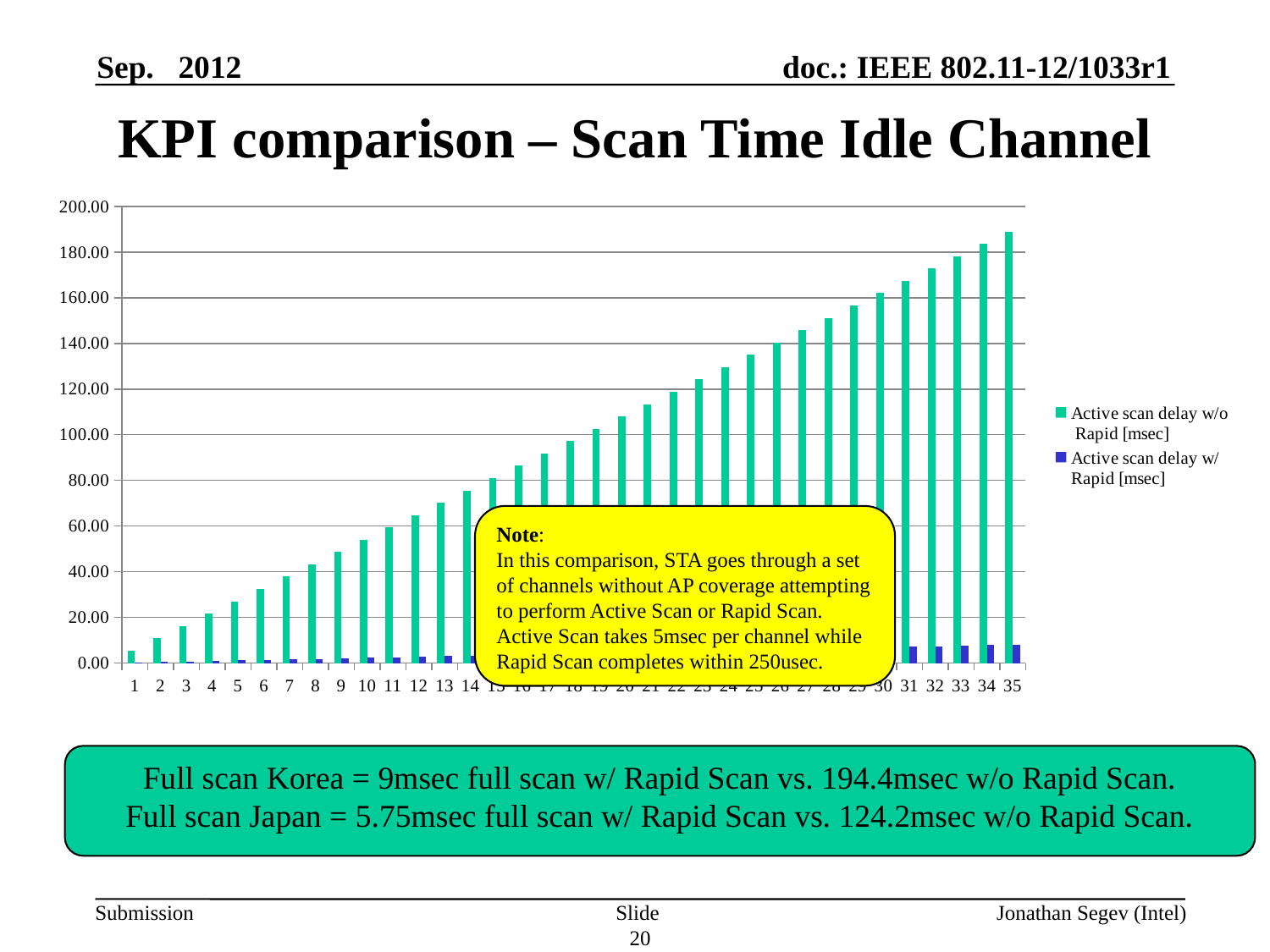
How many categories are shown along the x axis? 35 Do the values for 'Active scan delay w/o Rapid [msec]' rise or fall as the category number increases along the x axis? rise Which category has the lowest value for 'Active scan delay w/o Rapid [msec]'? 1 Which category has the highest value for 'Active scan delay w/o Rapid [msec]'? 35 Is the value for 'Active scan delay w/o Rapid [msec]' at category 35 greater or less than 180? greater Is the value for 'Active scan delay w/o Rapid [msec]' at category 1 greater or less than 20? less Is the value for 'Active scan delay w/o Rapid [msec]' at category 10 greater or less than 40? greater At category 35, which series has the larger value: 'Active scan delay w/o Rapid [msec]' or 'Active scan delay w/ Rapid [msec]'? Active scan delay w/o Rapid [msec] How many series does the legend list? 2 What are the two series names listed in the legend? Active scan delay w/o Rapid [msec]; Active scan delay w/ Rapid [msec] What kind of chart is shown on the slide? bar chart